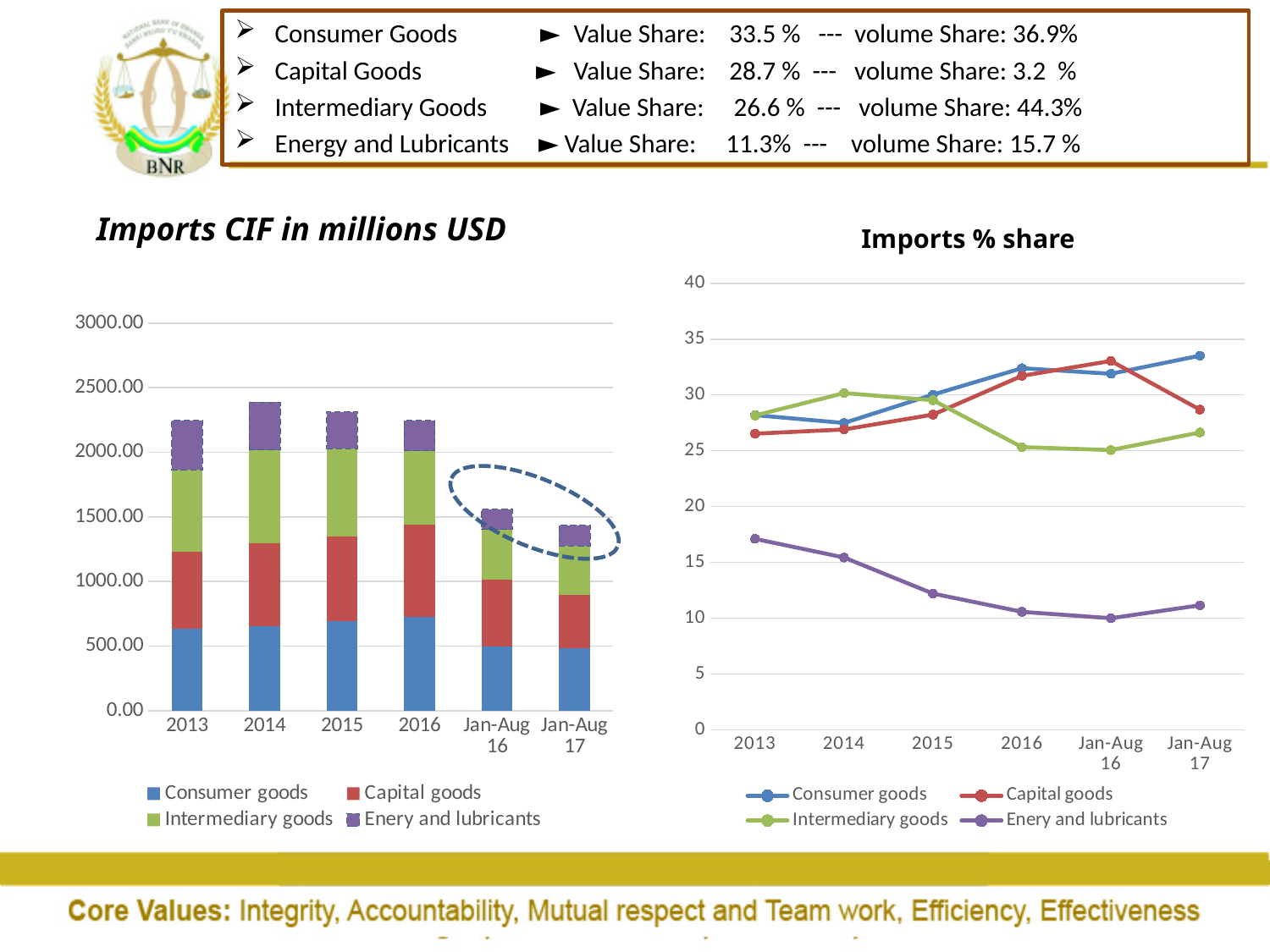
In the 'Imports % share' chart, which series has the lowest values across all years? Enery and lubricants In the 'Imports CIF in millions USD' chart, how many categories are shown on the x axis? 6 In the 'Imports CIF in millions USD' chart, which category has the highest total stacked bar? 2014 In the 'Imports % share' chart, in 2016, which is larger: Capital goods or Intermediary goods? Capital goods What kind of chart is the 'Imports CIF in millions USD' chart? Bar chart In the 'Imports % share' chart, is the Enery and lubricants value for 2013 greater or less than 15? greater In the 'Imports CIF in millions USD' chart, how many series does the legend list? 4 In the 'Imports CIF in millions USD' chart, which category has the lowest total stacked bar? Jan-Aug 17 What kind of chart is the 'Imports % share' chart? Line chart In the 'Imports CIF in millions USD' chart, is the total bar for Jan-Aug 17 greater or less than 1500.00? less In the 'Imports CIF in millions USD' chart, is the total bar for 2014 greater or less than 2000.00? greater In the 'Imports % share' chart, which series has the highest value in Jan-Aug 17? Consumer goods